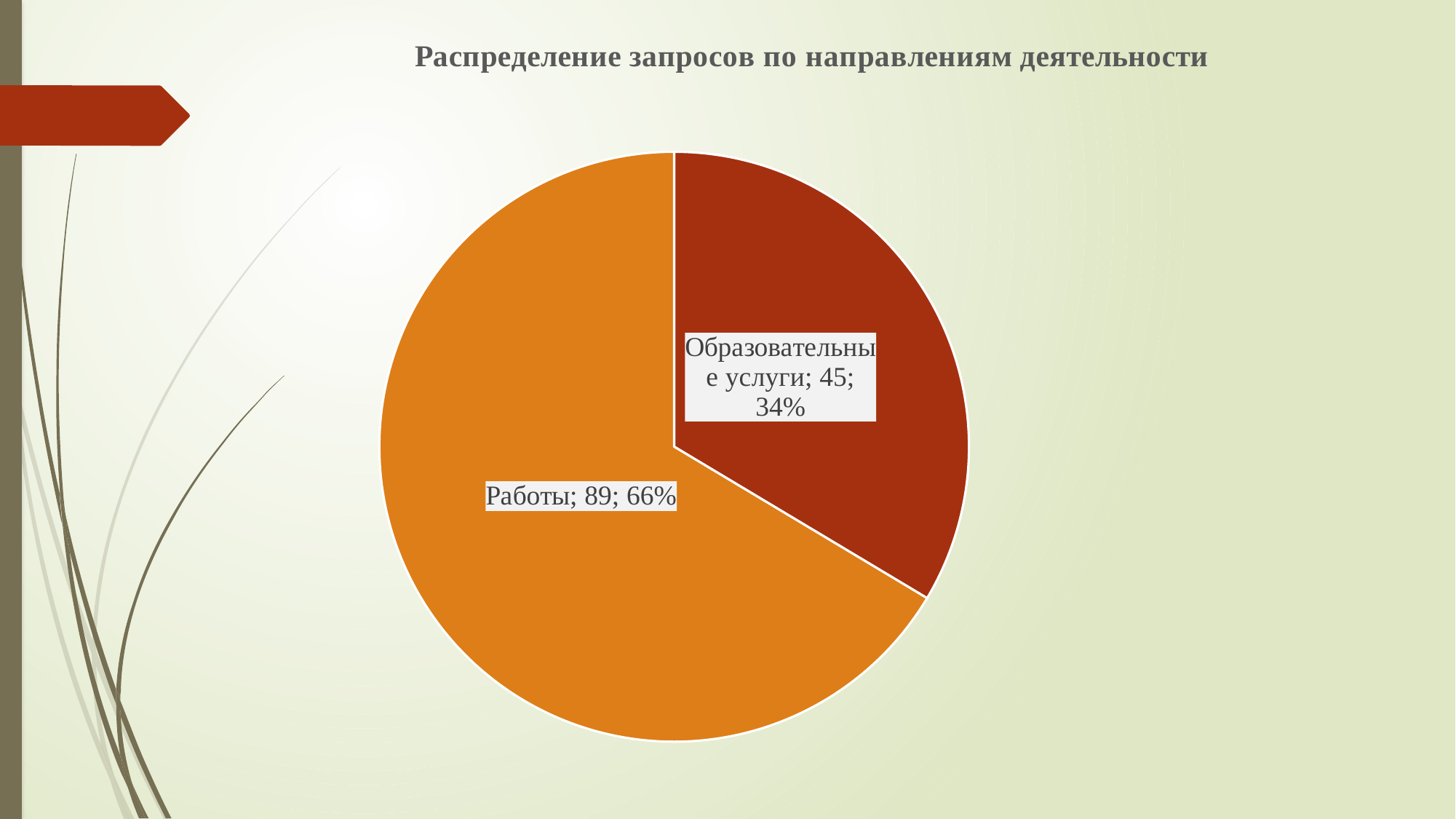
Which category has the largest slice? Работы How many slices does the pie chart have? 2 Which category has the smallest slice? Образовательные услуги What is the total of the two slice values? 134 What is the value for Образовательные услуги? 45 What is the difference between the values for Работы and Образовательные услуги? 44 What kind of chart is shown on the slide? pie chart What share of the pie does Образовательные услуги represent? 34% What share of the pie does Работы represent? 66% Which is larger, the value for Работы or the value for Образовательные услуги? Работы What is the title of the chart? Распределение запросов по направлениям деятельности What is the value for Работы? 89